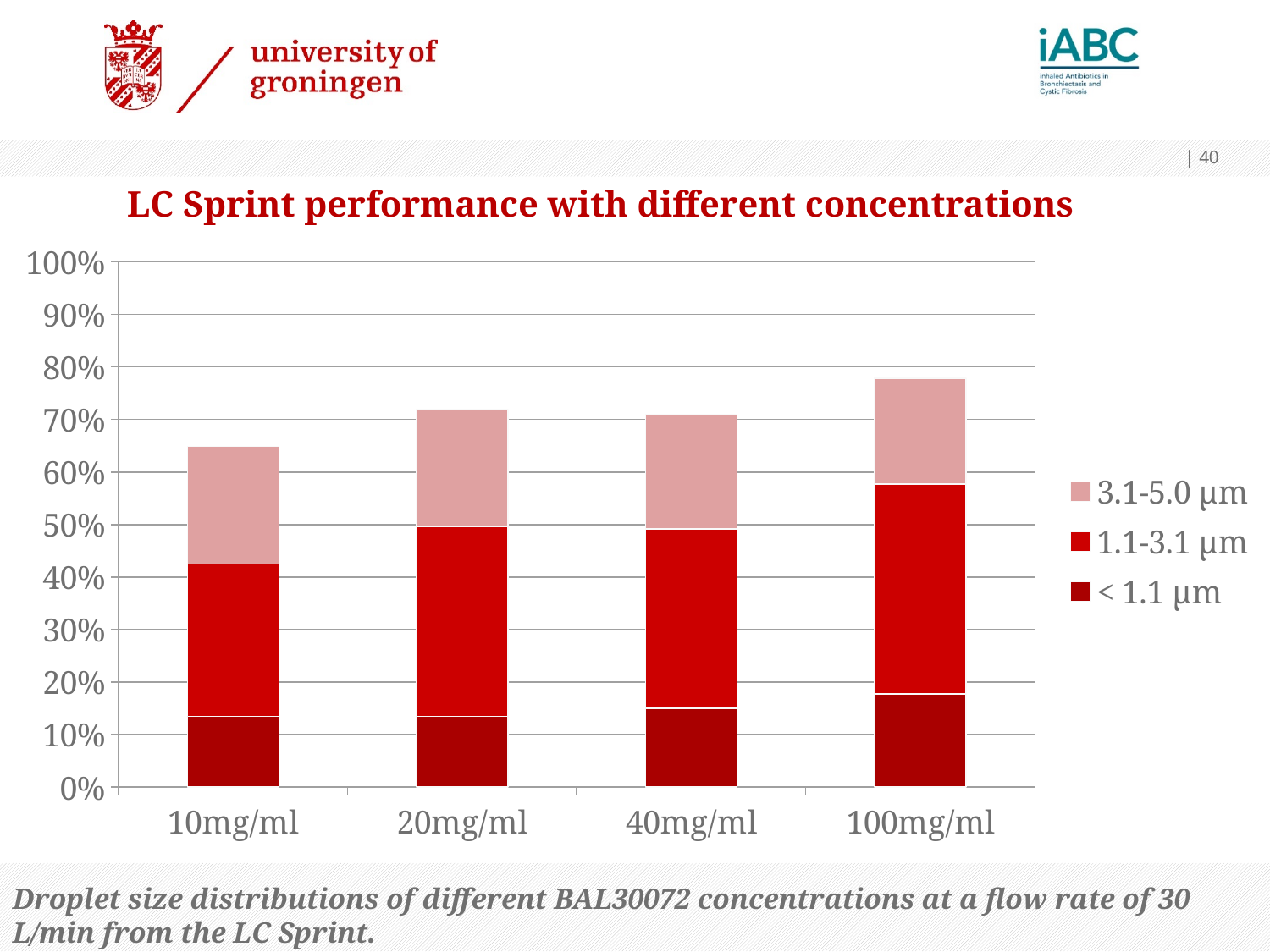
Is the total stacked bar for 10mg/ml greater or less than 60%? greater Is the total stacked bar for 100mg/ml greater or less than 80%? less Which has the larger total stacked bar, 10mg/ml or 100mg/ml? 100mg/ml Is the total stacked bar for 100mg/ml greater or less than 70%? greater Which concentration has the lowest total stacked bar? 10mg/ml How many series does the legend list? 3 What kind of chart is shown on the slide? stacked bar chart Which concentration has the highest total stacked bar? 100mg/ml How many concentration categories are shown on the x axis? 4 What is the title of the chart? LC Sprint performance with different concentrations Which legend entry is shown in the darkest red colour? < 1.1 µm